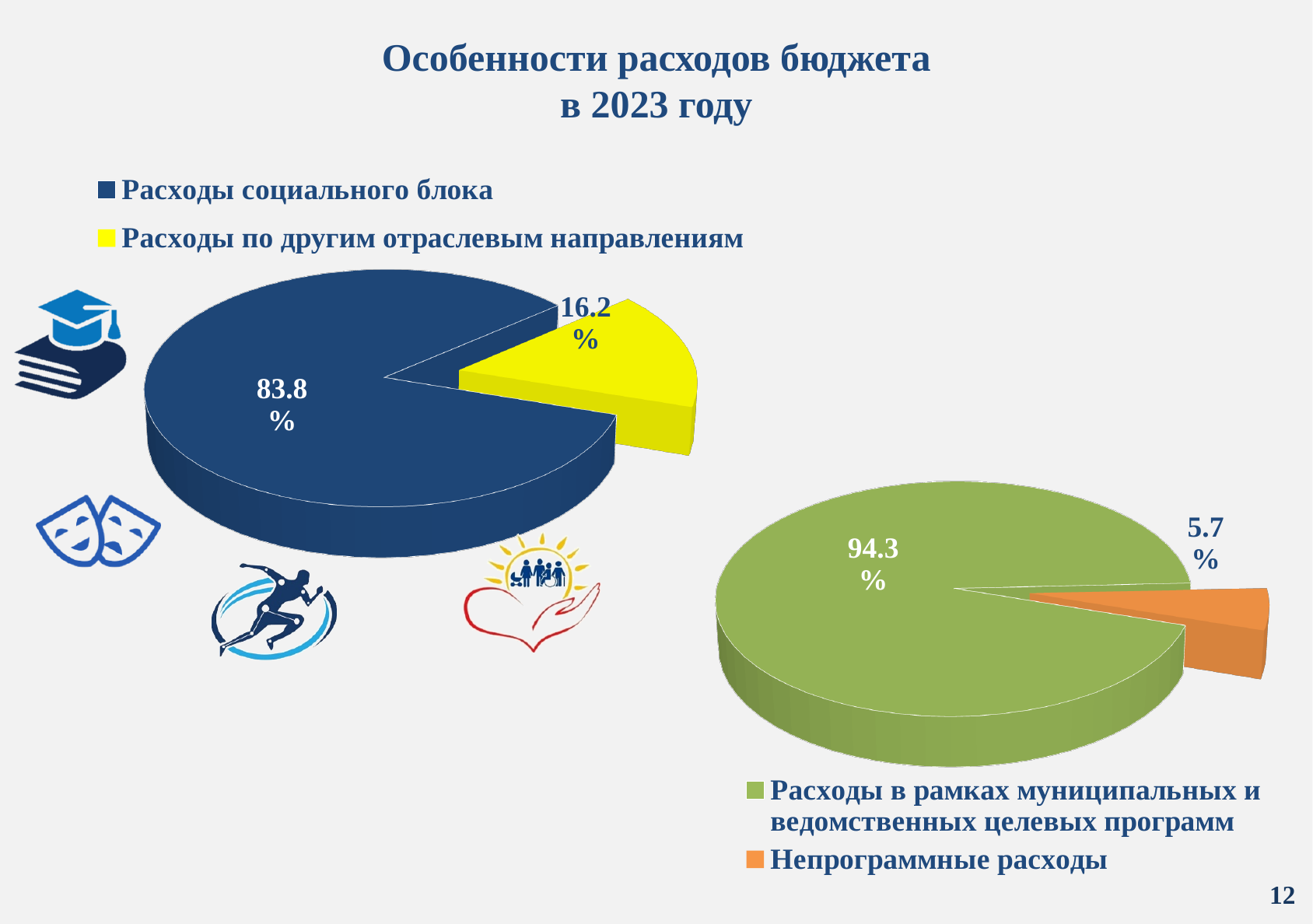
On the left pie chart, what share is shown for Расходы социального блока? 83.8% On the right pie chart, what share is shown for Расходы в рамках муниципальных и ведомственных целевых программ? 94.3% On the left pie chart, what is the difference in percentage points between Расходы социального блока and Расходы по другим отраслевым направлениям? 67.6 On the right pie chart, what share is shown for Непрограммные расходы? 5.7% What type of chart is the left chart? Pie chart Which is larger: the share of Непрограммные расходы on the right chart or the share of Расходы по другим отраслевым направлениям on the left chart? Расходы по другим отраслевым направлениям How many slices does the right pie chart have? 2 On the right pie chart, what is the difference in percentage points between Расходы в рамках муниципальных и ведомственных целевых программ and Непрограммные расходы? 88.6 On the left pie chart, which category has the largest share? Расходы социального блока On the right pie chart, what colour is the slice for Непрограммные расходы? Orange On the left pie chart, what share is shown for Расходы по другим отраслевым направлениям? 16.2% On the right pie chart, which category has the smallest share? Непрограммные расходы